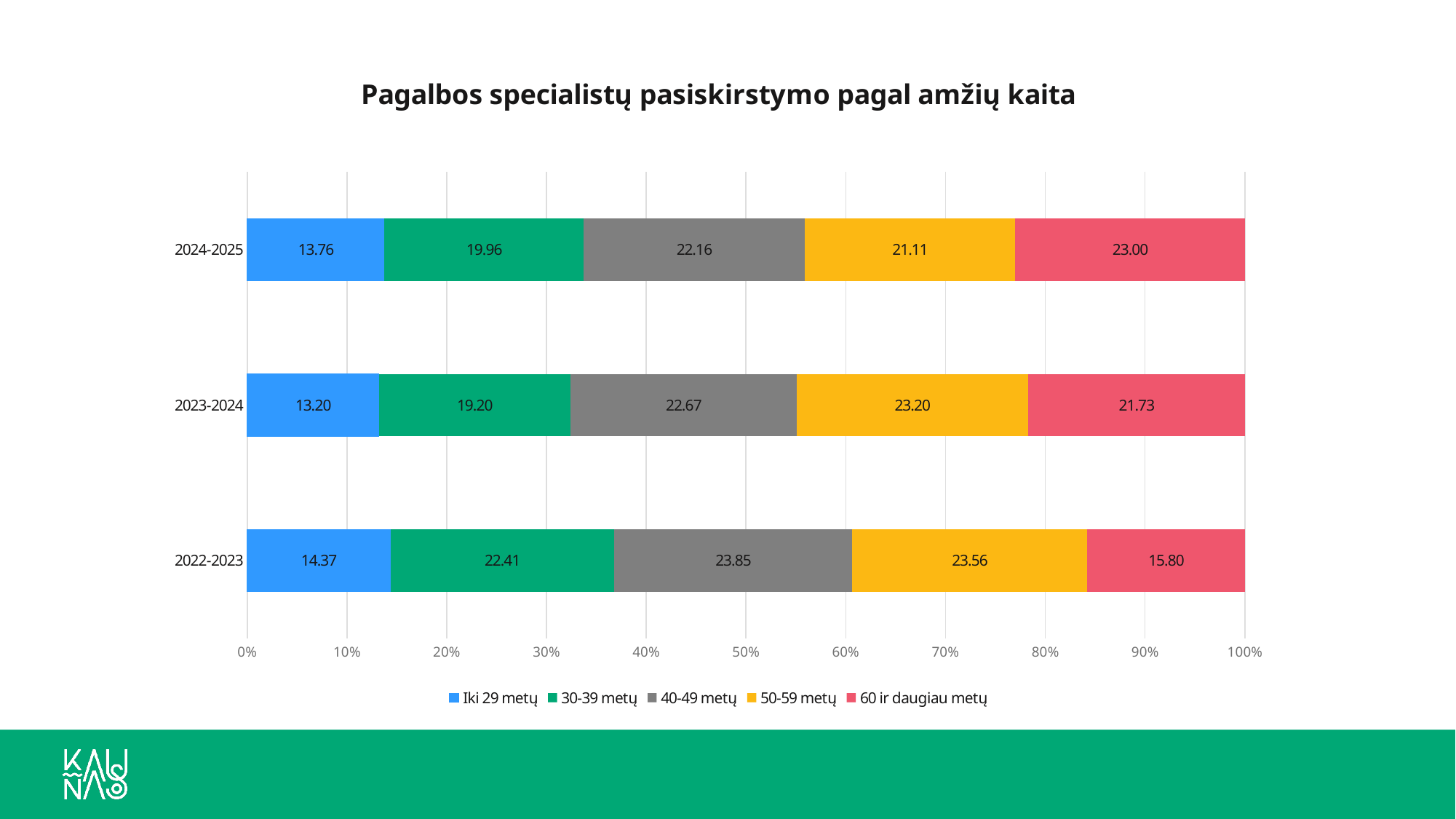
How many periods (categories) are shown on the chart? 3 What is the value for the 50-59 metų series in 2023-2024? 23.20 What is the value for the 40-49 metų series in 2022-2023? 23.85 Does the value for the 60 ir daugiau metų series rise or fall from 2022-2023 to 2024-2025? Rise In which period is the value for the 60 ir daugiau metų series highest? 2024-2025 What is the title of the chart? Pagalbos specialistų pasiskirstymo pagal amžių kaita What kind of chart is shown on the slide? Stacked bar chart How many series does the legend list? 5 Which is larger: the 30-39 metų value for 2022-2023 or for 2024-2025? 2022-2023 What is the difference between the 60 ir daugiau metų values for 2024-2025 and 2022-2023? 7.20 In which period is the value for the Iki 29 metų series lowest? 2023-2024 What is the value for the Iki 29 metų series in 2024-2025? 13.76